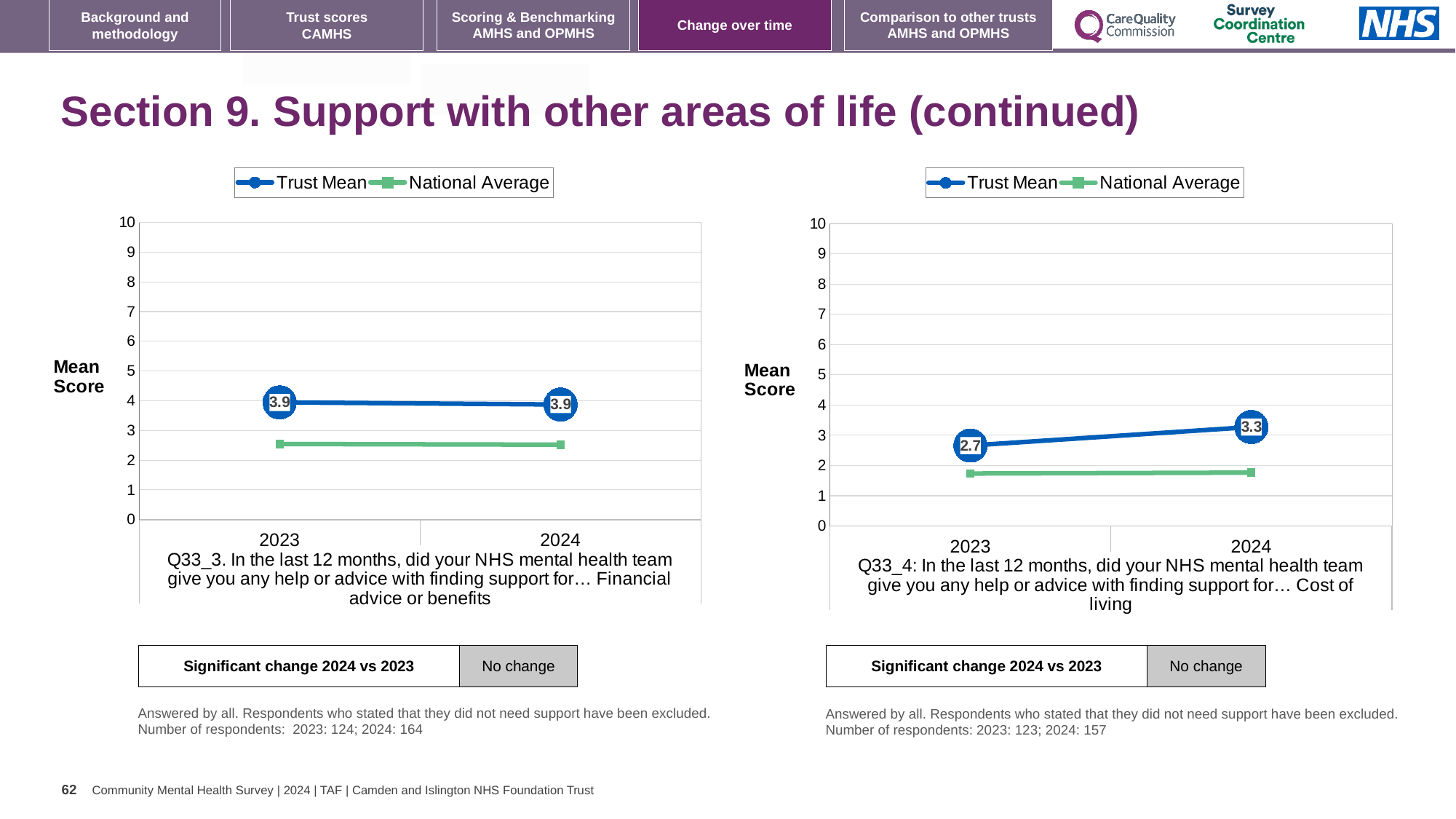
On the left chart (Q33_3, Financial advice or benefits), what is the Trust Mean for 2024? 3.9 On the right chart (Q33_4, Cost of living), by how much did the Trust Mean change from 2023 to 2024? 0.6 How many series does the legend of the right chart (Q33_4, Cost of living) list? 2 On the right chart (Q33_4, Cost of living), what is the Trust Mean for 2024? 3.3 On the right chart (Q33_4, Cost of living), what is the Trust Mean for 2023? 2.7 On the left chart (Q33_3, Financial advice or benefits), what is the Trust Mean for 2023? 3.9 On the right chart (Q33_4, Cost of living), which year has the higher Trust Mean, 2023 or 2024? 2024 On the left chart (Q33_3, Financial advice or benefits), which series is higher in 2024, Trust Mean or National Average? Trust Mean On the left chart (Q33_3, Financial advice or benefits), is the National Average for 2024 greater or less than 3? less On the right chart (Q33_4, Cost of living), is the National Average for 2023 greater or less than 2? less On the right chart (Q33_4, Cost of living), does the Trust Mean rise or fall from 2023 to 2024? rise What kind of chart is the left chart (Q33_3, Financial advice or benefits)? line chart